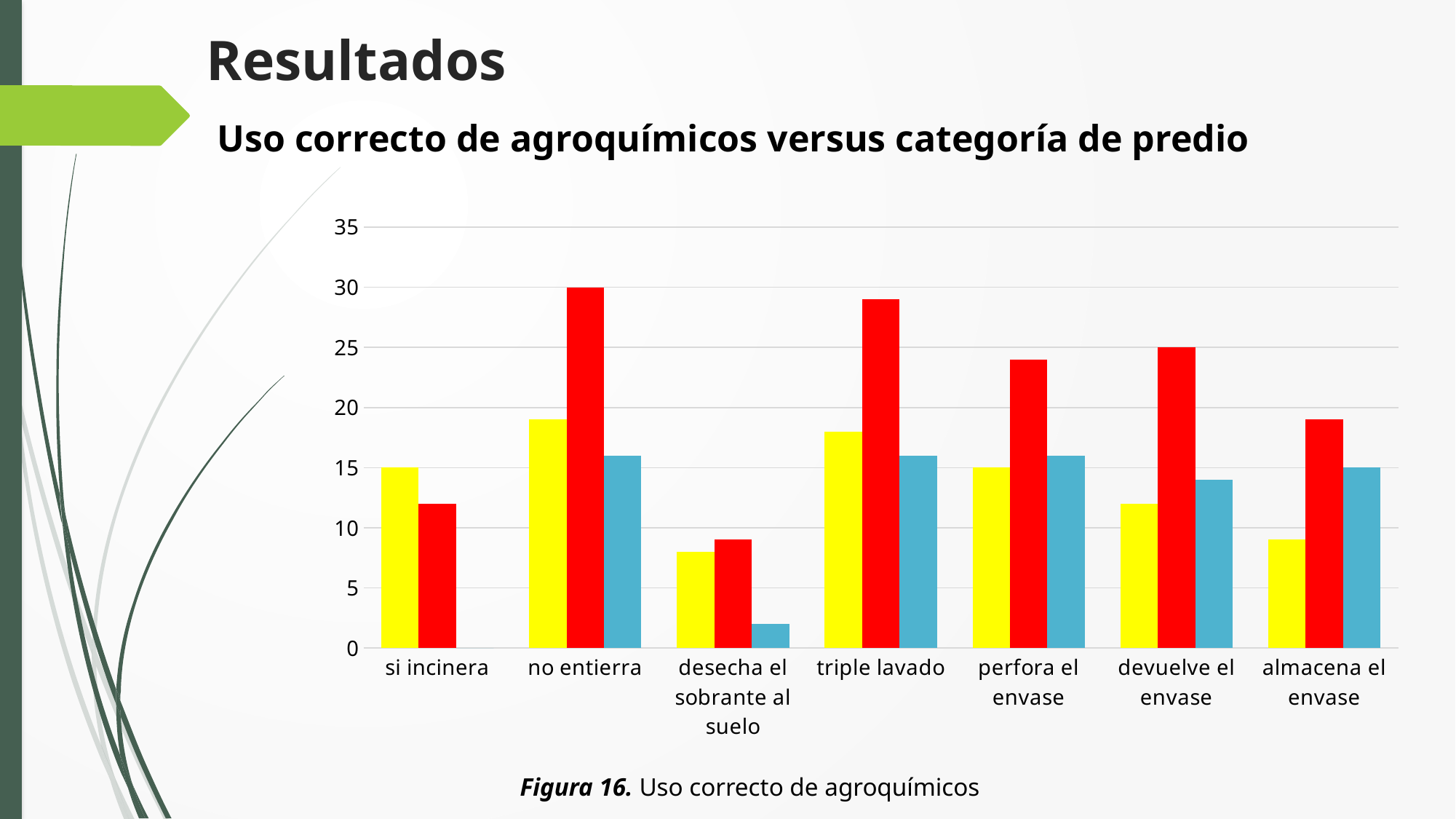
Is the value of the red bar for "triple lavado" greater or less than 25? greater How many categories are shown on the x axis of the chart? 7 What is the figure caption shown below the chart? Figura 16. Uso correcto de agroquímicos Which category has the lowest red bar? desecha el sobrante al suelo Is the value of the blue bar for "desecha el sobrante al suelo" greater or less than 5? less What is the value of the red bar for "no entierra"? 30 What is the value of the red bar for "devuelve el envase"? 25 What kind of chart is shown on the slide? bar chart Which category has the tallest red bar? no entierra For "si incinera", which bar is taller, the yellow bar or the red bar? the yellow bar What is the value of the yellow bar for "si incinera"? 15 What is the difference between the red bar for "no entierra" and the red bar for "devuelve el envase"? 5